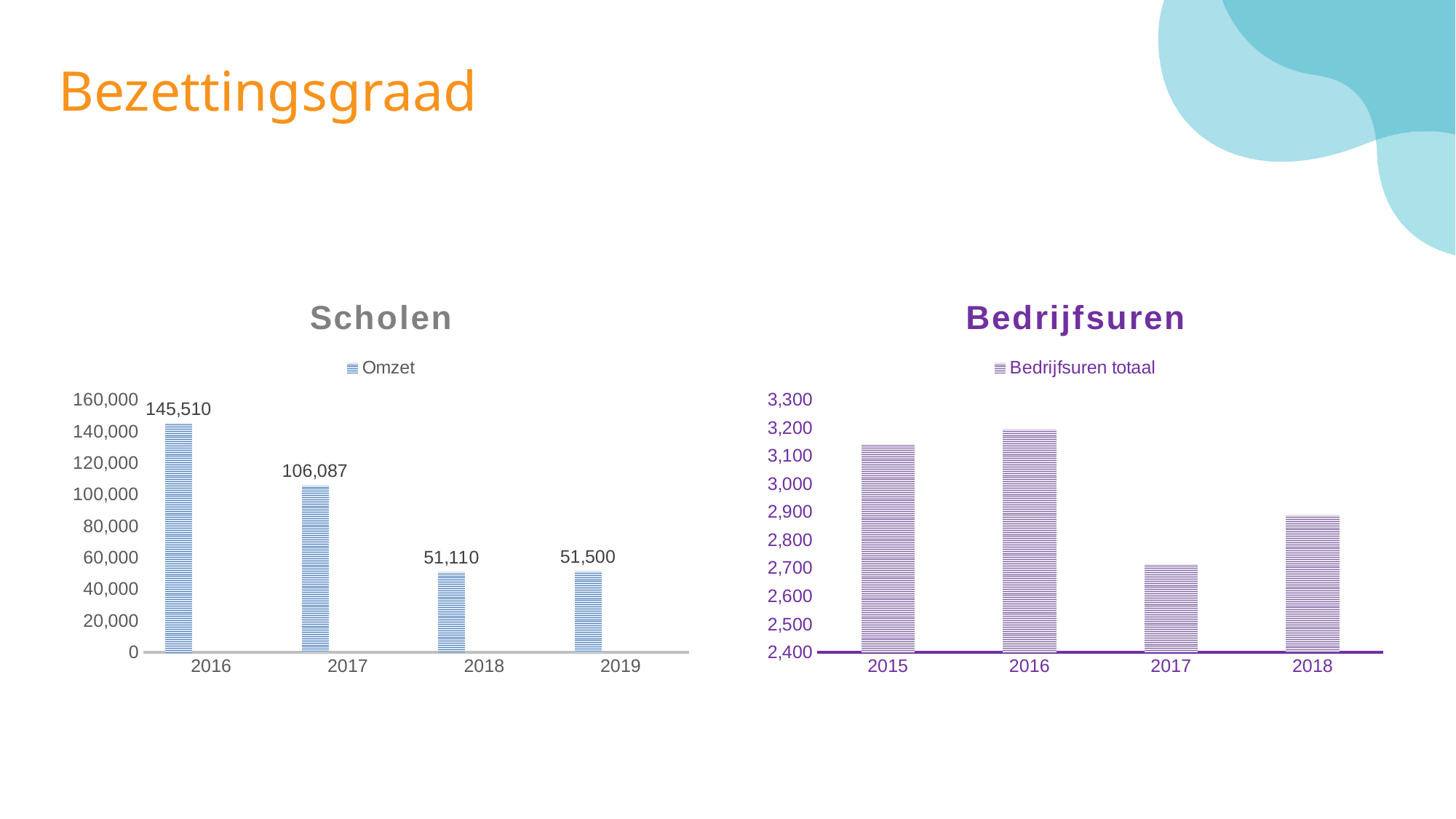
In the Scholen chart, which year has the highest Omzet? 2016 In the Scholen chart, what is the difference in Omzet between 2016 and 2017? 39,423 In the Scholen chart, what is the difference in Omzet between 2019 and 2018? 390 In the Scholen chart, how many years are shown on the x axis? 4 What kind of chart is the Bedrijfsuren chart? bar chart In the Bedrijfsuren chart, is the value for 2017 greater or less than 2,800? less In the Bedrijfsuren chart, which year has the highest value? 2016 In the Scholen chart, what is the Omzet value for 2018? 51,110 In the Scholen chart, what is the Omzet value for 2016? 145,510 In the Scholen chart, does Omzet rise or fall from 2016 to 2018? fall In the Bedrijfsuren chart, which year has the lowest value? 2017 In the Bedrijfsuren chart, is the value for 2015 greater or less than 3,000? greater